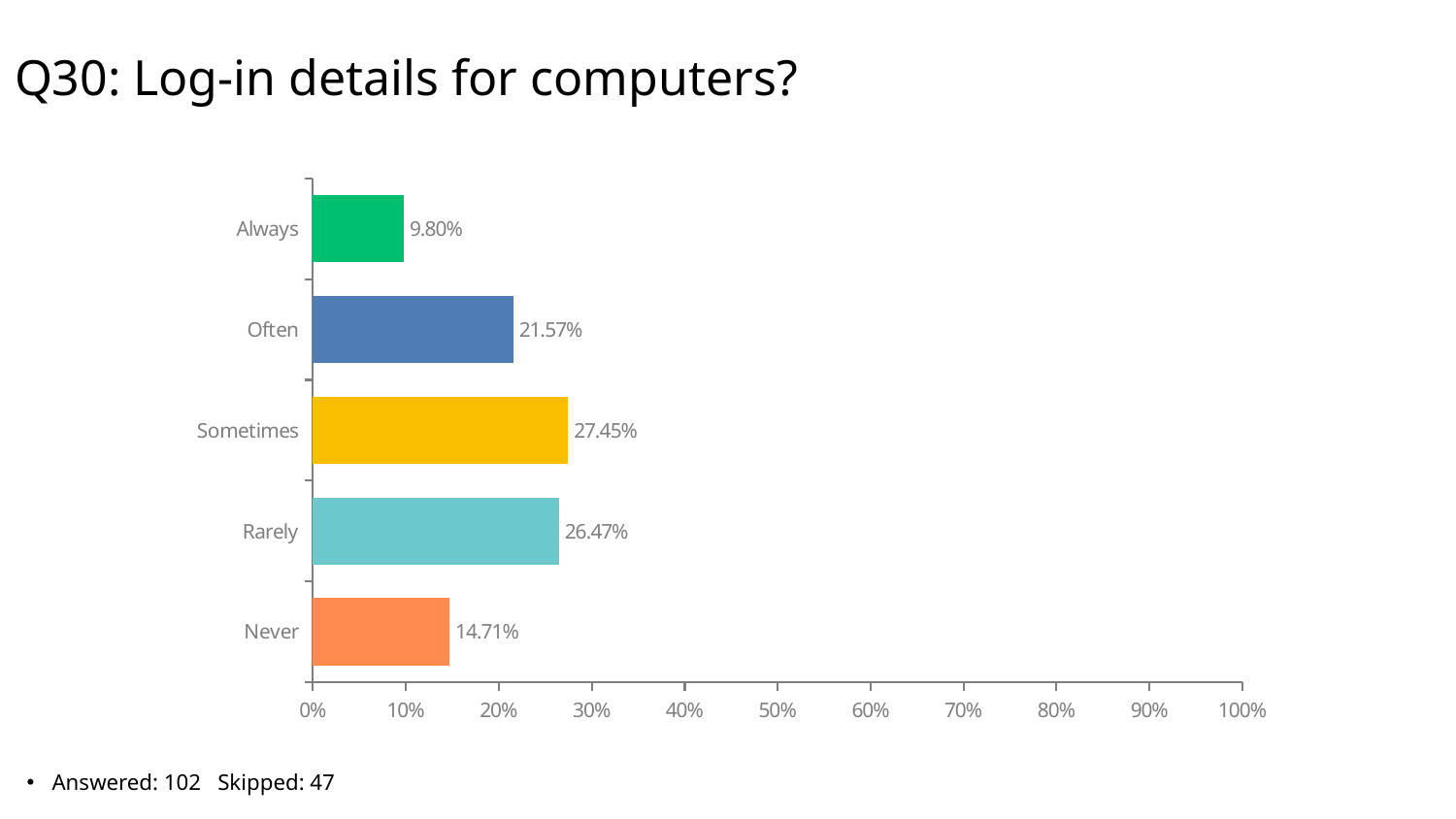
Which is larger, the value for Often or the value for Never? Often Is the value for Rarely greater or less than 20%? greater What is the value for Never? 14.71% Which category has the lowest value? Always What is the value for Rarely? 26.47% What is the value for Often? 21.57% What kind of chart is shown on the slide? bar chart What is the difference between the values for Often and Never? 6.86% What is the value for Sometimes? 27.45% What is the value for Always? 9.80% How many categories are shown in the chart? 5 Which category has the highest value? Sometimes